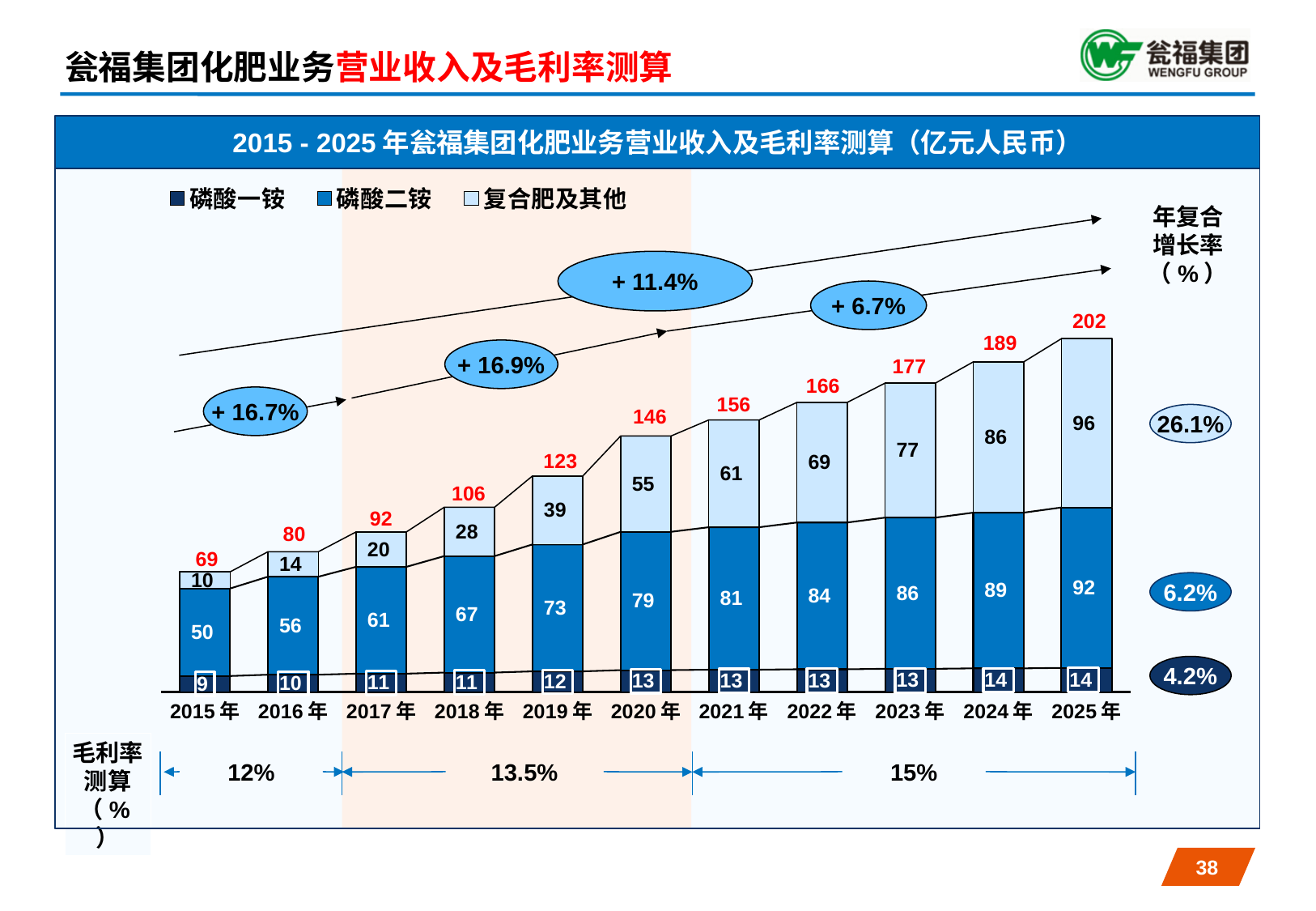
Which is larger, the 复合肥及其他 value in 2024 年 or the 磷酸二铵 value in 2024 年? 磷酸二铵 value in 2024 年 How many years are shown on the x axis? 11 What is the value for 磷酸二铵 in 2020 年? 79 Which year has the lowest total stacked bar value? 2015 年 Do the total values rise or fall from 2015 年 to 2025 年? Rise What kind of chart is shown? Stacked bar chart What is the value for 磷酸一铵 in 2015 年? 9 How many series does the legend list? 3 What is the difference between the total for 2021 年 and the total for 2020 年? 10 Which year has the highest total stacked bar value? 2025 年 What is the total of the stacked bar for 2025 年? 202 What is the value for 复合肥及其他 in 2023 年? 77